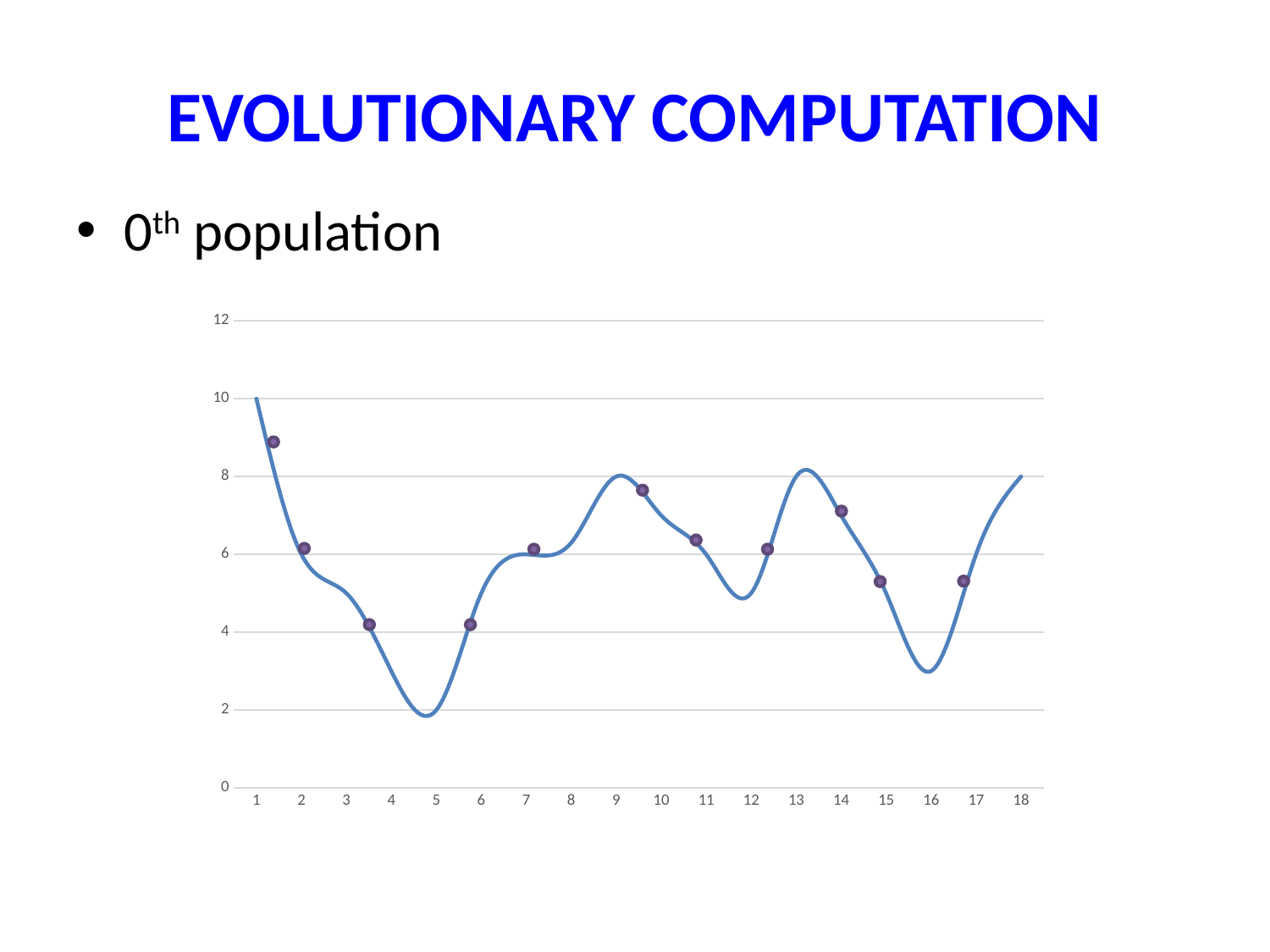
Does the curve rise or fall between x = 1 and x = 5? fall Is the value of the curve at x = 5 greater or less than 4? less Is the value of the curve at x = 16 greater or less than 4? less What is the value of the curve at x = 1? 10 What kind of chart is shown on the slide? line chart What is the highest value labelled on the y axis of the chart? 12 Is the value of the curve at x = 13 greater or less than 6? greater What is the value of the curve at x = 18? 8 Is the curve higher at x = 9 or at x = 5? 9 At which x value does the curve reach its highest point? 1 How many tick labels are shown on the x axis of the chart? 18